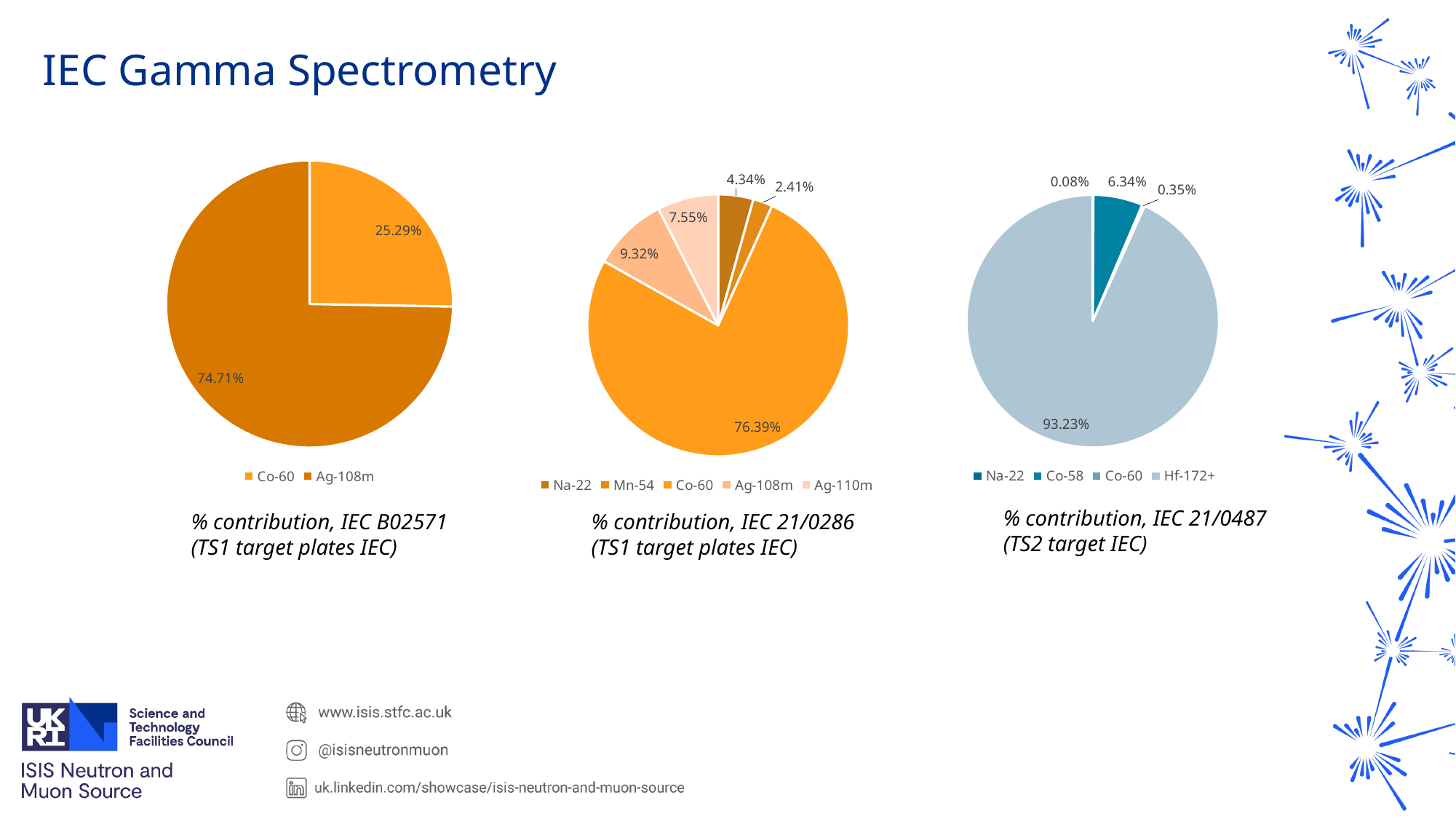
In the IEC 21/0487 pie chart, which is larger, the share for Co-58 or the share for Co-60? Co-58 How many isotopes does the legend of the IEC 21/0286 chart list? 5 In the IEC 21/0286 pie chart, what percentage is shown for Ag-108m? 9.32% In the IEC 21/0487 pie chart, what percentage is shown for Hf-172+? 93.23% In the IEC 21/0487 pie chart, which isotope has the smallest share? Na-22 In the IEC B02571 pie chart, what percentage is shown for Ag-108m? 74.71% What type of chart is used for the IEC 21/0487 (TS2 target IEC) data? Pie chart In the IEC 21/0286 pie chart, what is the difference between the Ag-108m and Ag-110m shares? 1.77% In the IEC 21/0286 pie chart, which isotope has the smallest share? Mn-54 In the IEC 21/0487 pie chart, what percentage is shown for Co-58? 6.34% In the IEC 21/0286 pie chart, what percentage is shown for Co-60? 76.39% In the IEC B02571 pie chart, what percentage is shown for Co-60? 25.29%